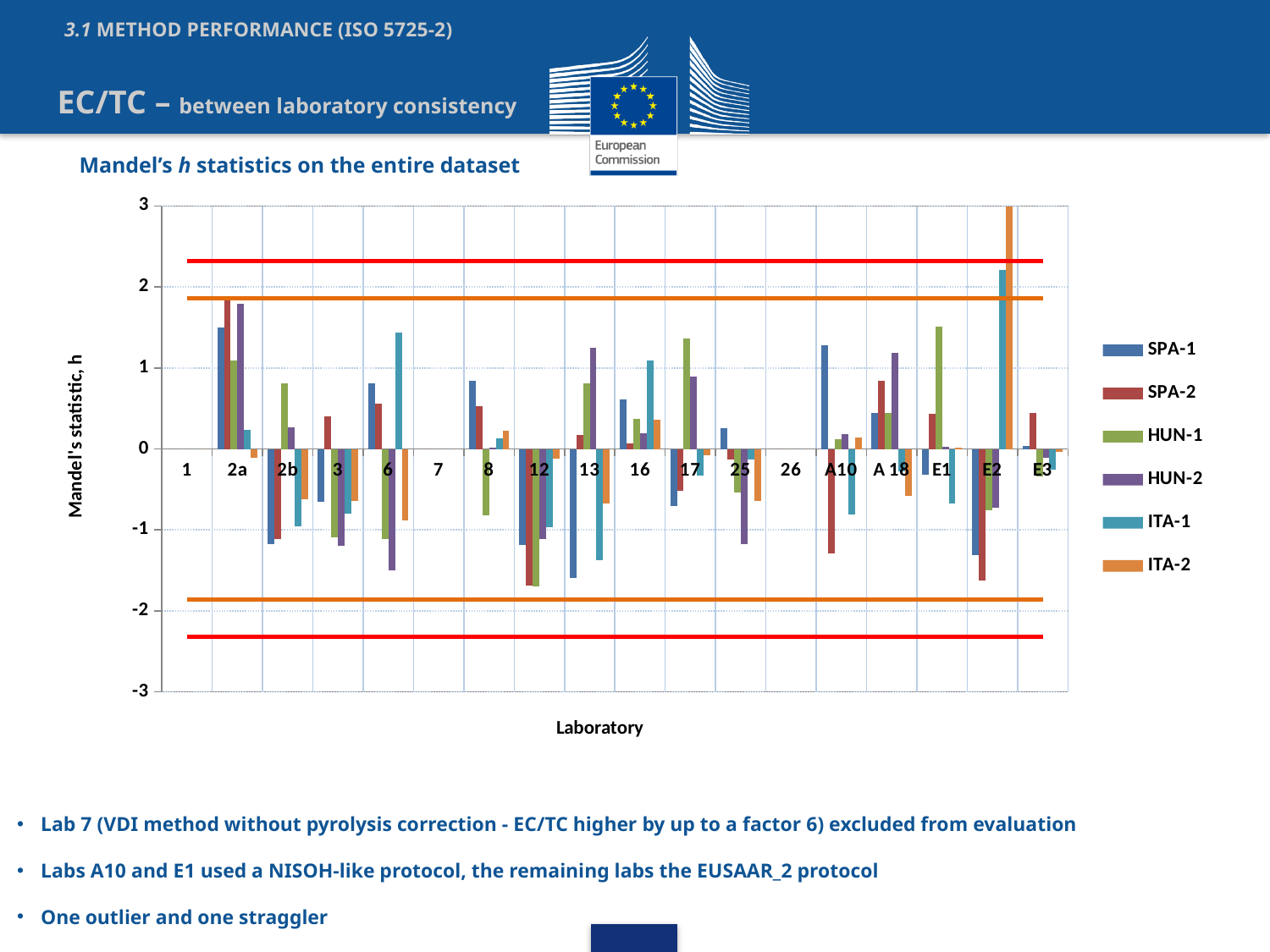
Is the SPA-2 value for laboratory 12 greater or less than -1? less Is the HUN-1 value for laboratory E1 greater or less than 1? greater What kind of chart is shown on the slide? bar chart For laboratory 2a, which is larger: the SPA-1 value or the HUN-2 value? HUN-2 How many laboratory categories are shown on the x axis? 18 What is the title of the x axis? Laboratory Is the ITA-1 value for laboratory 6 greater or less than 1? greater How many series does the legend list? 6 Which laboratory has the highest ITA-2 value? E2 What is the title of the y axis? Mandel's statistic, h